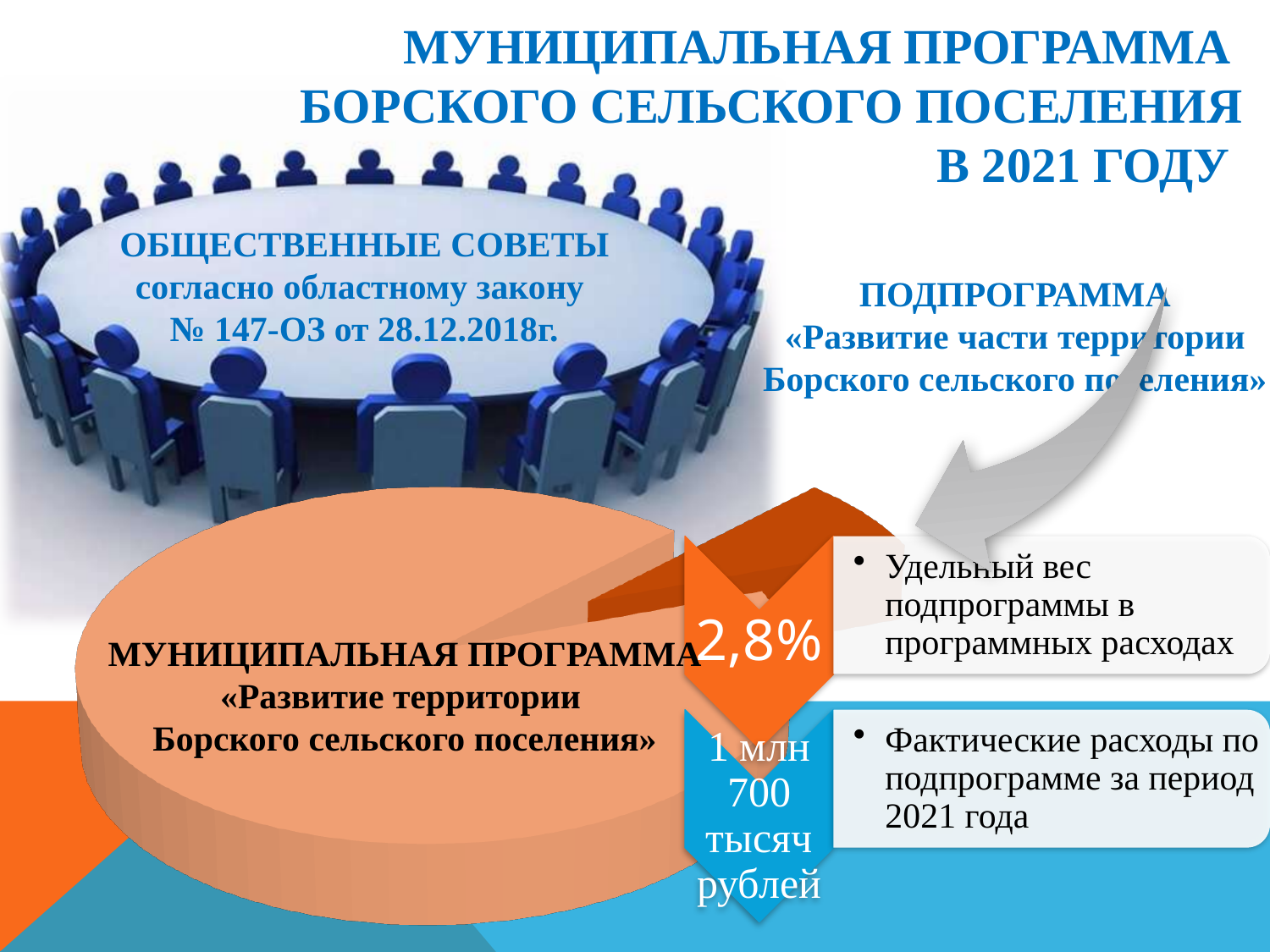
What kind of chart is shown on the slide? Pie chart Which is larger: the slice for the municipal programme «Развитие территории Борского сельского поселения» or the exploded slice for the subprogramme? The municipal programme slice What share of the pie does the exploded slice for the subprogramme «Развитие части территории Борского сельского поселения» represent? 2,8% What does the 2,8% label on the pie chart represent, according to the callout next to it? Удельный вес подпрограммы в программных расходах What value is given for the actual expenses on the subprogramme for 2021 (Фактические расходы по подпрограмме за период 2021 года)? 1 млн 700 тысяч рублей Is the share of the exploded subprogramme slice greater or less than 50%? less How many slices does the pie chart have? 2 What colour is the exploded slice of the pie chart? Orange